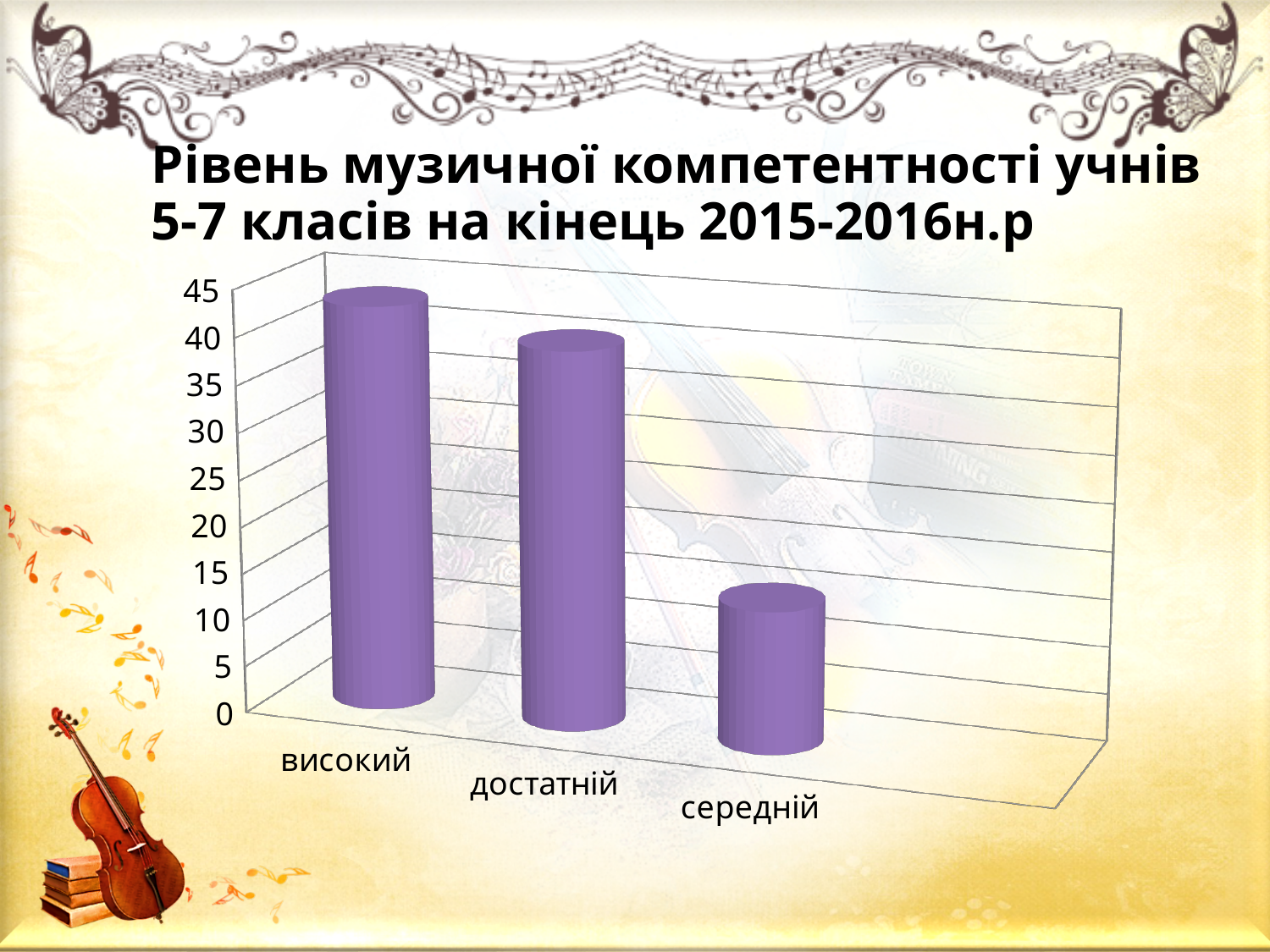
Is the value for середній greater or less than 20? less Is the value for достатній greater or less than 30? greater Which category has the lowest value? середній Do the values rise or fall from left to right across the categories? fall Which is larger, the value for високий or the value for середній? високий Is the value for середній greater or less than 5? greater How many categories are plotted in the chart? 3 What kind of chart is shown on the slide? bar chart What is the title of the chart on the slide? Рівень музичної компетентності учнів 5-7 класів на кінець 2015-2016н.р Which is larger, the value for достатній or the value for середній? достатній Which category has the highest value? високий